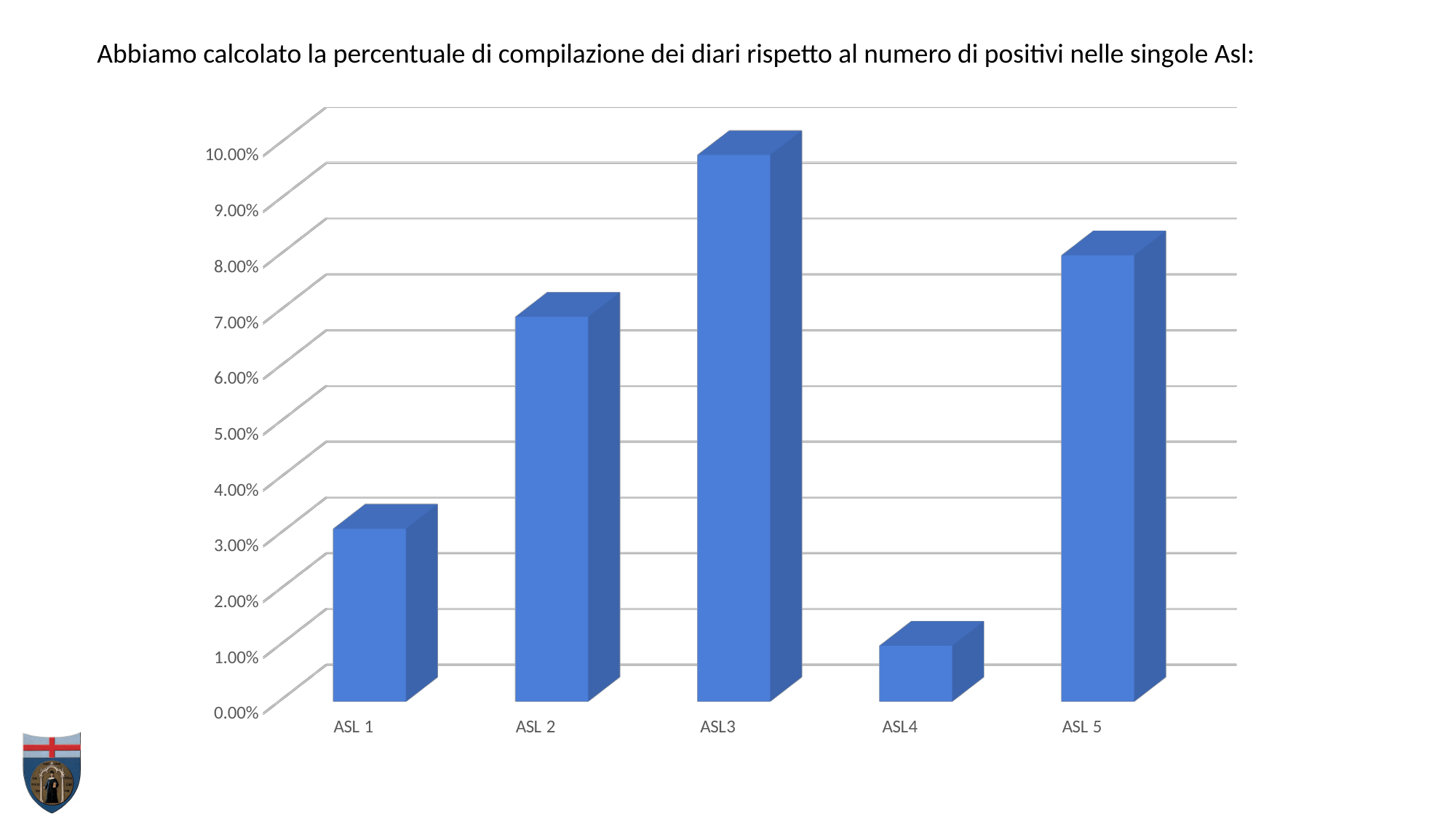
Is the value for ASL3 greater or less than 9.00%? greater How many ASL categories are plotted on the chart? 5 Is the value for ASL 2 greater or less than 6.00%? greater Is the value for ASL 1 greater or less than 2.00%? greater Which ASL has the highest percentage on the chart? ASL3 Which has a higher value, ASL 2 or ASL 5? ASL 5 What kind of chart is shown on the slide? Bar chart Which ASL has the lowest percentage on the chart? ASL4 Does the value rise or fall from ASL3 to ASL4? fall Which has a higher value, ASL 1 or ASL 2? ASL 2